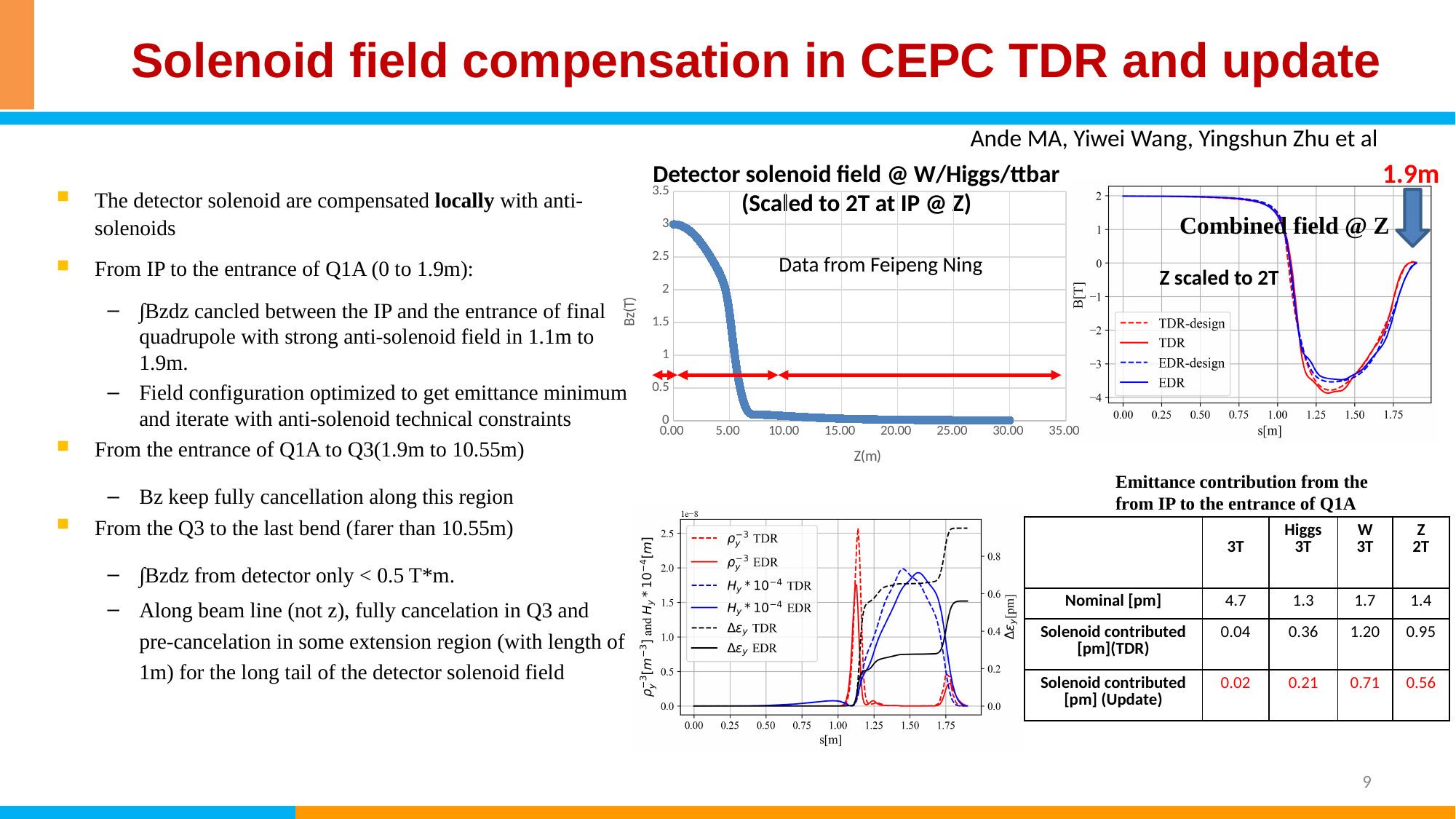
In the 'Detector solenoid field @ W/Higgs/ttbar' chart, does Bz rise or fall as Z increases from 0 to 10 m? fall In the 'Combined field @ Z' chart, is the minimum value of the TDR curve greater or less than -3? less How many series does the legend of the 'Combined field @ Z' chart list? 4 In the 'Combined field @ Z' chart, which series are drawn with dashed lines? TDR-design and EDR-design In the 'Detector solenoid field @ W/Higgs/ttbar' chart, is the value of Bz at Z = 20 m greater or less than 0.5? less How many series does the legend of the bottom-left chart (with s[m] on the x axis) list? 6 In the bottom-left chart, is the value of Δεy TDR at s = 1.75 greater or less than 0.8? greater In the 'Combined field @ Z' chart, what is the value of B[T] at s = 0? 2 In the 'Detector solenoid field @ W/Higgs/ttbar' chart, what is the label of the vertical axis? Bz(T) In the bottom-left chart, at s = 1.75, which is larger: Δεy TDR or Δεy EDR? Δεy TDR What kind of chart is the 'Detector solenoid field @ W/Higgs/ttbar' chart at the top centre? scatter chart